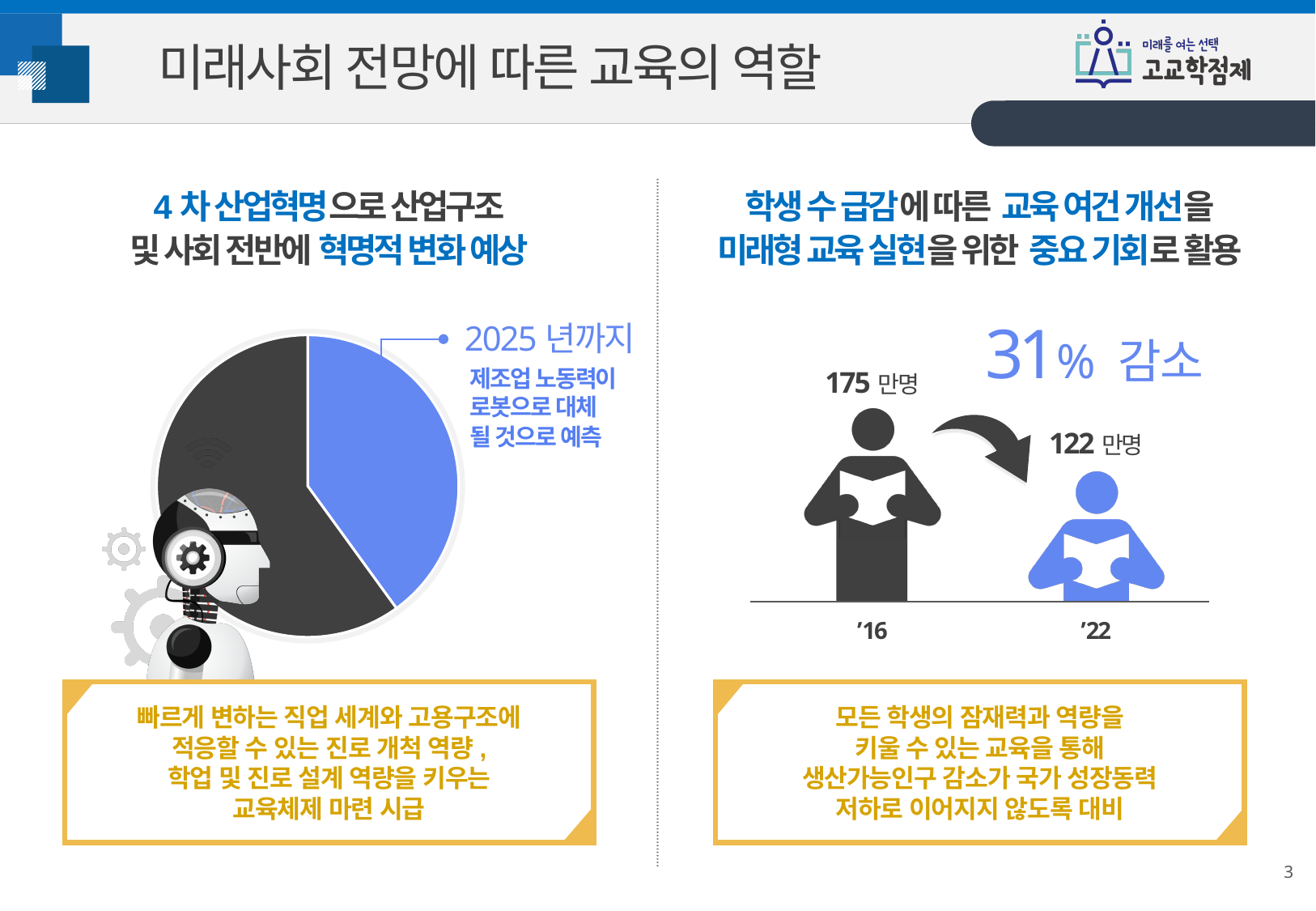
In the student-number infographic on the right, how many years are shown? 2 In the student-number infographic on the right, what is the value shown for '16? 175 만명 How many slices does the pie chart on the left side of the slide have? 2 What kind of chart is shown on the left side of the slide? pie chart In the student-number infographic on the right, what is the difference between the '16 value and the '22 value? 53 만명 In the pie chart on the left, is the blue slice's share greater or less than 50%? less In the student-number infographic on the right, what is the value shown for '22? 122 만명 In the student-number infographic on the right, which year has the larger value, '16 or '22? '16 In the pie chart on the left, which slice is larger, the blue slice or the dark gray slice? dark gray slice In the pie chart on the left, what year is mentioned in the callout attached to the blue slice? 2025 In the student-number infographic on the right, what percentage decrease is shown? 31% In the student-number infographic on the right, does the value rise or fall from '16 to '22? fall